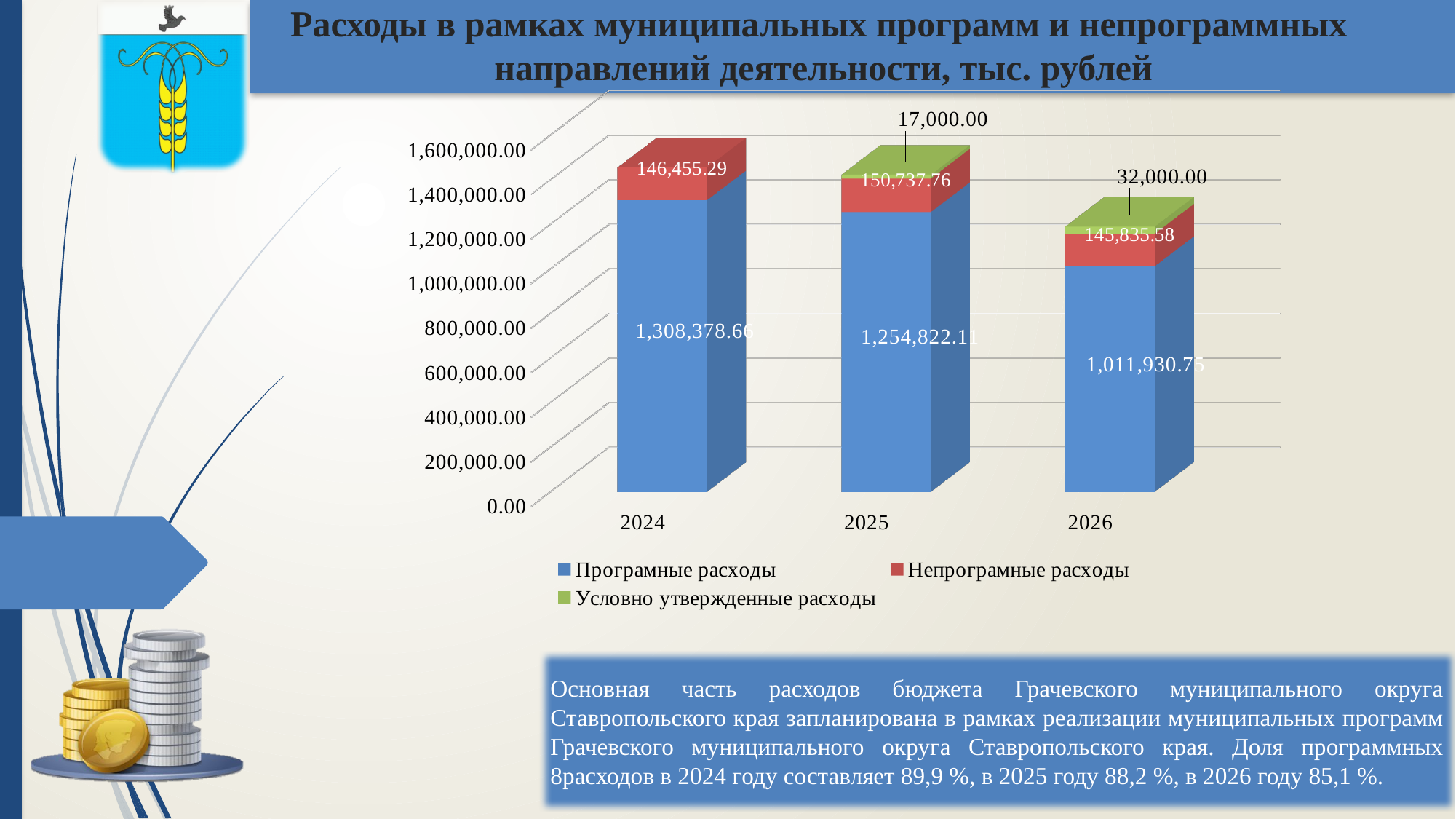
How many years are shown on the x axis? 3 What is the difference between Условно утвержденные расходы in 2026 and in 2025? 15,000.00 Which is larger: Програмные расходы in 2025 or in 2026? 2025 How many series does the legend list? 3 What is the value of Програмные расходы for 2024? 1,308,378.66 In which year are Непрограмные расходы the highest? 2025 Do Програмные расходы rise or fall from 2024 to 2026? fall What is the total of the stacked bar for 2026? 1,189,766.33 In which year are Програмные расходы the lowest? 2026 What is the value of Условно утвержденные расходы for 2025? 17,000.00 What is the difference between Програмные расходы in 2024 and in 2026? 296,447.91 What is the value of Непрограмные расходы for 2026? 145,835.58